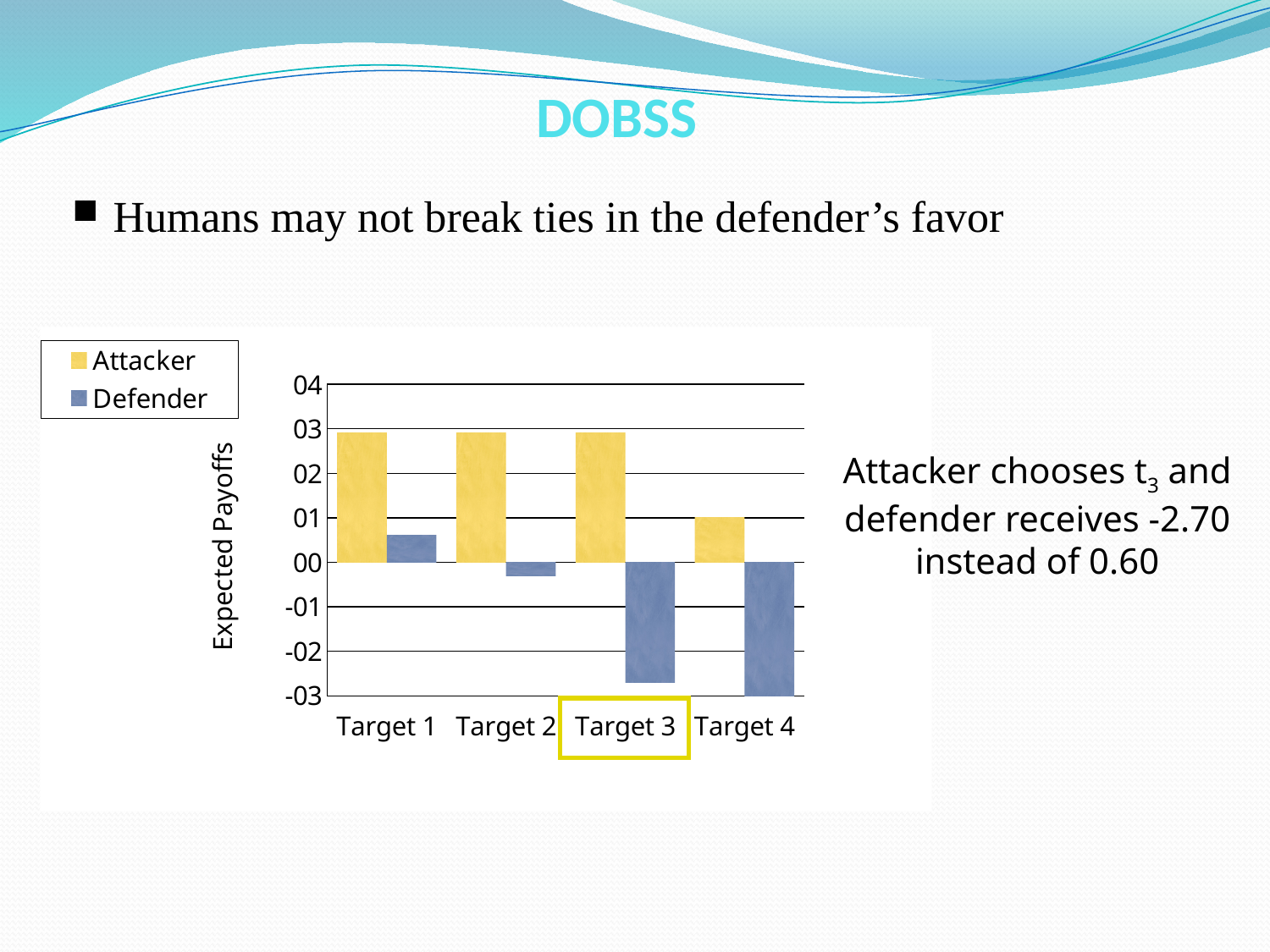
What is the label on the vertical axis of the chart? Expected Payoffs How many targets are shown on the x axis of the chart? 4 Which target has the lowest Attacker expected payoff? Target 4 Is the Defender value for Target 3 greater or less than -02? less According to the slide text, what payoff does the defender receive when the attacker chooses t3? -2.70 What kind of chart is shown on the slide? bar chart For Target 3, which series has the larger expected payoff, Attacker or Defender? Attacker Is the Attacker value for Target 1 greater or less than 02? greater Is the Defender value for Target 2 greater or less than -01? greater How many series does the chart legend list? 2 Which target has the highest Defender expected payoff? Target 1